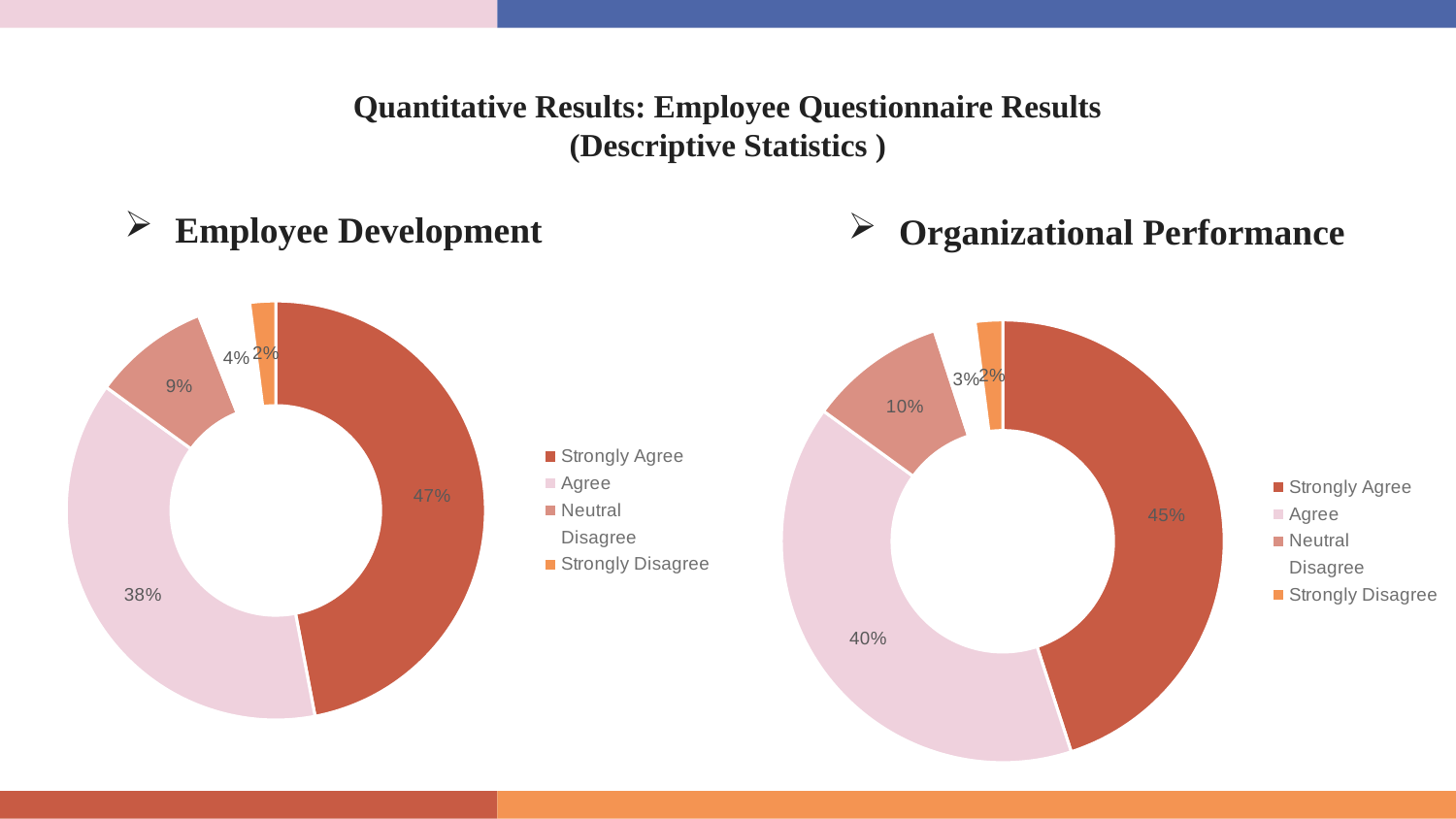
In the Organizational Performance chart, what percentage is shown for Neutral? 10% In the Employee Development chart, which response category has the largest share? Strongly Agree In the Employee Development chart, what colour is the Strongly Disagree slice? Orange In the Organizational Performance chart, what percentage is shown for Disagree? 3% What kind of chart is used for Employee Development? Doughnut chart In the Employee Development chart, what is the difference between the Strongly Agree and Agree percentages? 9% In the Organizational Performance chart, which response category has the smallest share? Strongly Disagree In the Employee Development chart, what percentage is shown for Agree? 38% How many response categories does the legend of the Organizational Performance chart list? 5 In the Employee Development chart, what percentage is shown for Strongly Agree? 47% In the Organizational Performance chart, what is the difference between the Agree and Neutral percentages? 30% Which chart shows a larger share for Agree, Employee Development or Organizational Performance? Organizational Performance